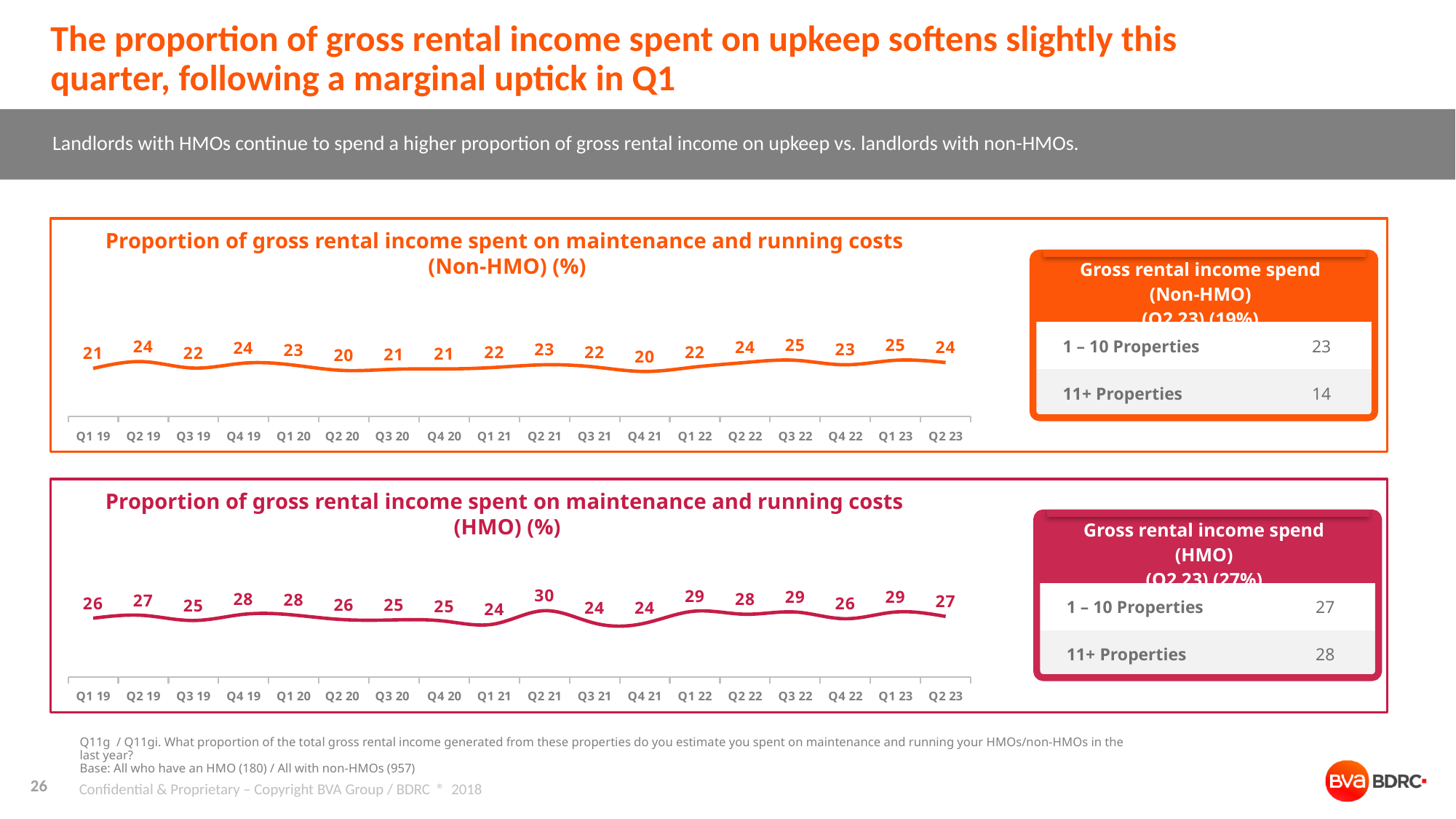
How many quarters are plotted in the HMO chart? 18 In the Non-HMO chart, what is the value for Q2 23? 24 In the Non-HMO chart, which is larger: the value for Q2 19 or the value for Q3 19? Q2 19 In the HMO chart, what is the value for Q2 21? 30 What type of chart is the Non-HMO chart? Line chart In the HMO chart, what is the difference between the Q1 23 value and the Q2 23 value? 2 In the Non-HMO side panel, what is the Q2 23 value for landlords with 11+ Properties? 14 In the Non-HMO chart, what is the difference between the Q1 23 value and the Q2 23 value? 1 In the HMO chart, which quarter has the highest value? Q2 21 For Q2 23, which is larger: the Non-HMO value or the HMO value? HMO In the Non-HMO chart, what is the value for Q2 20? 20 In the HMO chart, what is the value for Q1 19? 26